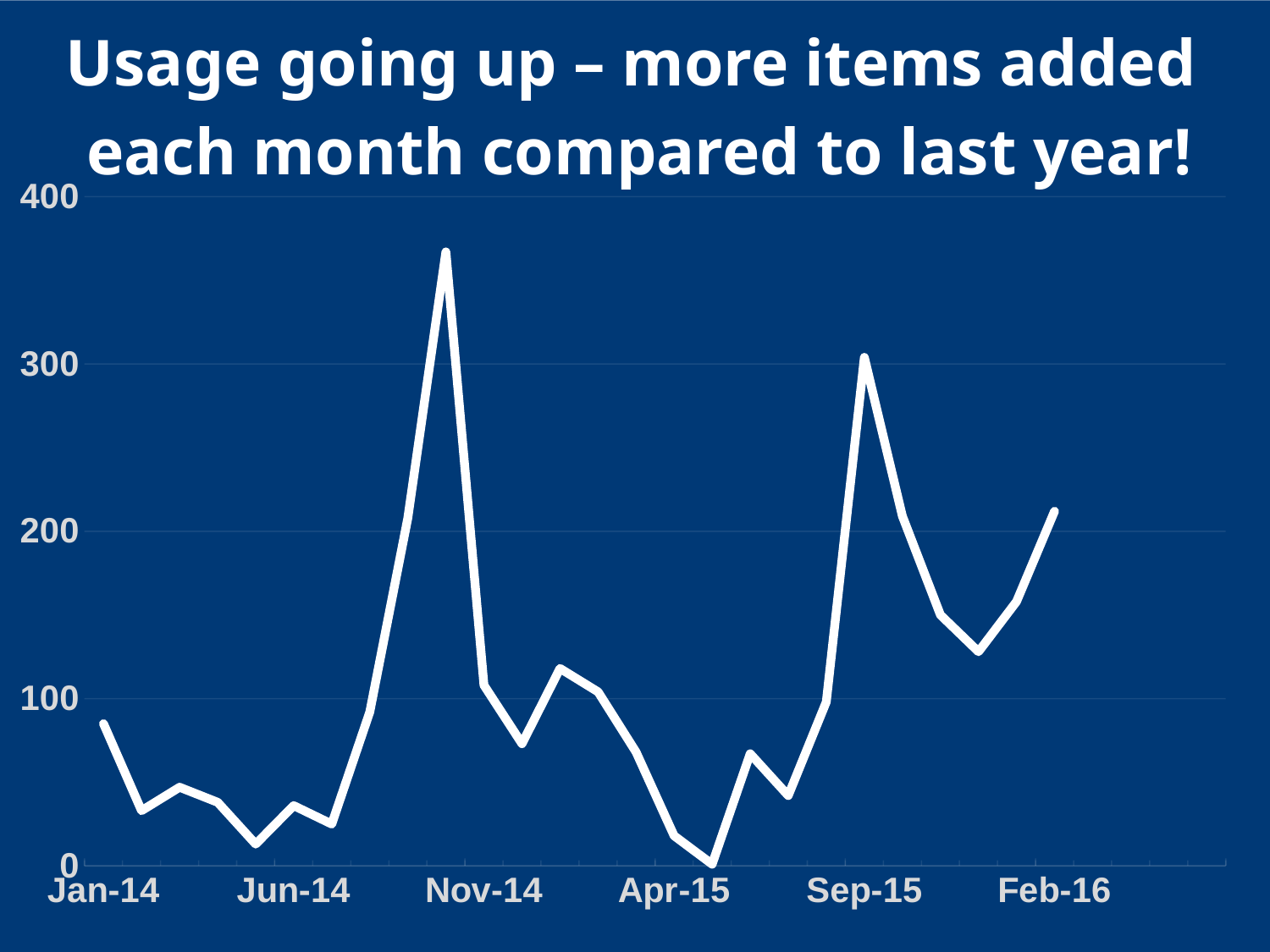
Is the value for Jun-14 greater or less than 100? less How many month labels are shown on the x axis? 6 Is the value for Feb-16 greater or less than 100? greater Between Apr-15 and Sep-15, does the line generally rise or fall? rise Is the value for Sep-15 greater or less than 200? greater Which has the larger value, Sep-15 or Jan-14? Sep-15 Which has the larger value, Jun-14 or Feb-16? Feb-16 What kind of chart is shown on the slide? line chart What is the title of the chart on the slide? Usage going up – more items added each month compared to last year!